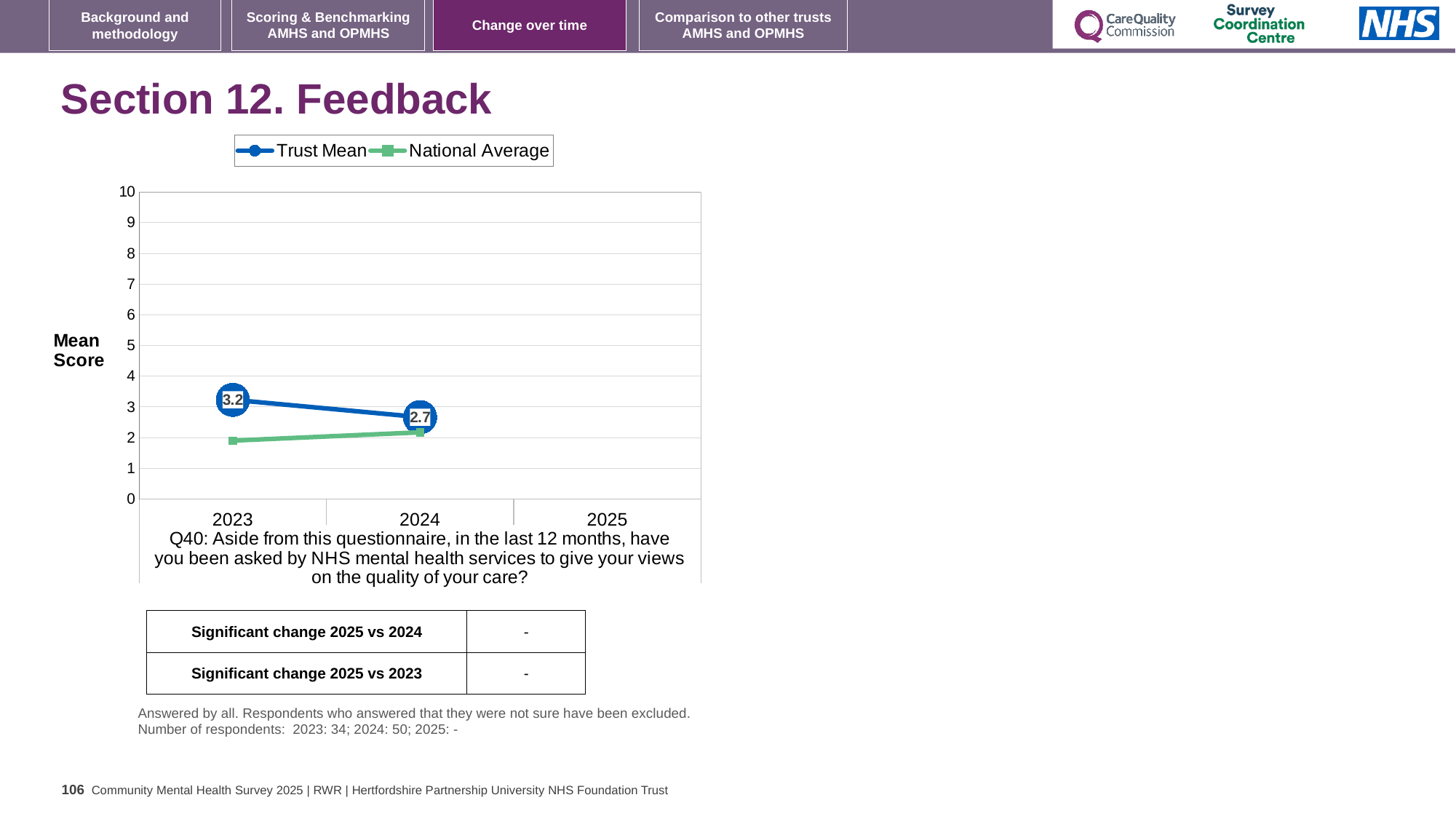
What is the difference between the Trust Mean in 2023 and in 2024? 0.5 Which is larger, the Trust Mean in 2023 or the Trust Mean in 2024? 2023 What is the Trust Mean value for 2024? 2.7 How many years are shown on the x axis? 3 What is the Trust Mean value for 2023? 3.2 Does the Trust Mean rise or fall from 2023 to 2024? Fall Is the National Average value for 2023 greater or less than 3? less In which year is the Trust Mean highest? 2023 How many series does the legend list? 2 What kind of chart is shown on the slide? Line chart In 2024, which series is higher, Trust Mean or National Average? Trust Mean Is the Trust Mean value for 2023 greater or less than 3? greater